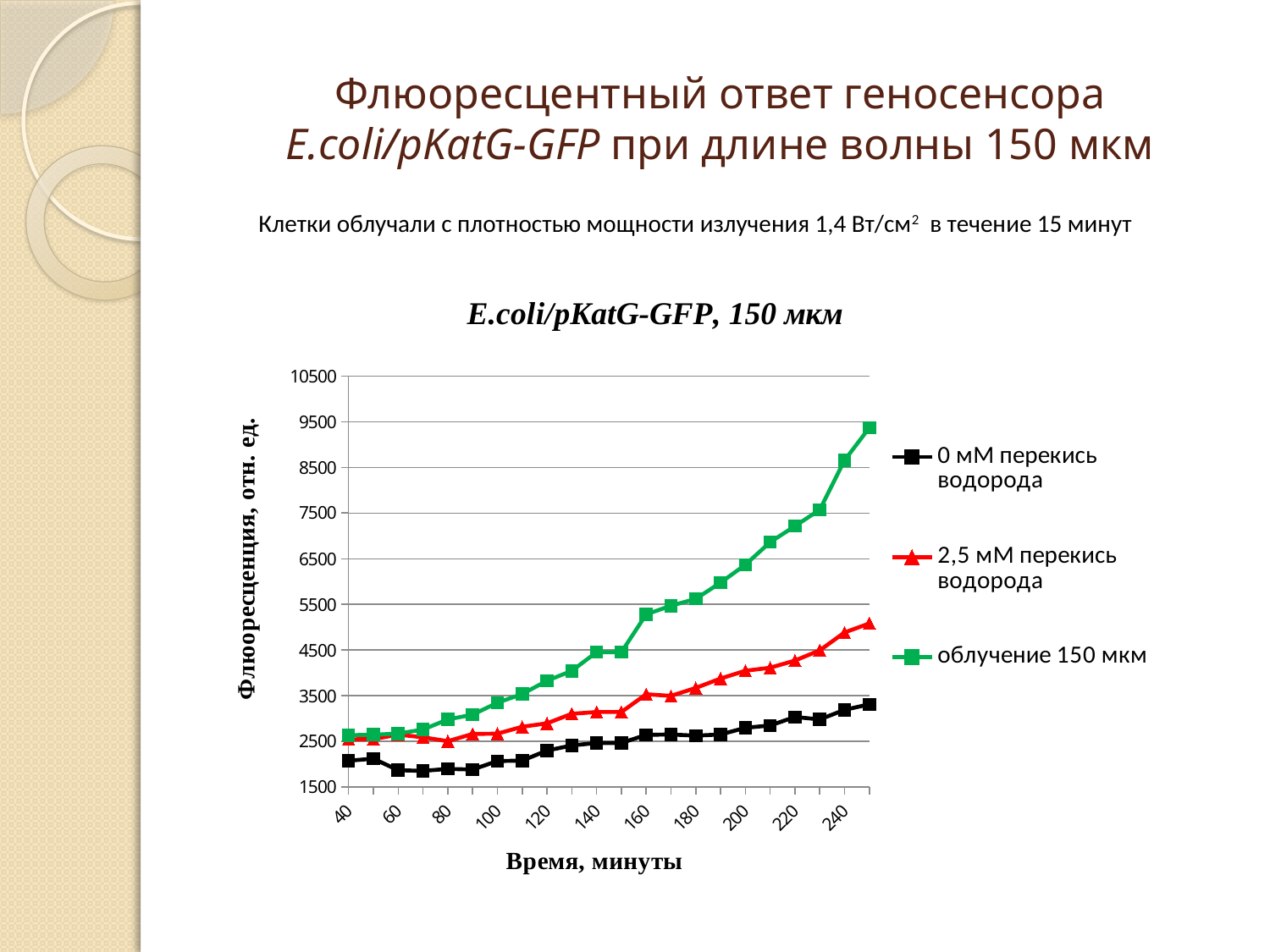
What kind of chart is shown on the slide? line chart What is the label of the x axis? Время, минуты Is the value for '0 мМ перекись водорода' at 60 minutes greater or less than 2500? less Is the value for 'облучение 150 мкм' at 240 minutes greater or less than 7500? greater How many series does the legend list? 3 Does the 'облучение 150 мкм' series rise or fall as time increases along the x axis? rise Which series has the lowest value at 240 minutes? 0 мМ перекись водорода Is the value for '0 мМ перекись водорода' at 240 minutes greater or less than 3500? less What is the title of the chart? E.coli/pKatG-GFP, 150 мкм Which series has the highest value at 240 minutes? облучение 150 мкм At 240 minutes, which is larger: the value for 'облучение 150 мкм' or the value for '2,5 мМ перекись водорода'? облучение 150 мкм